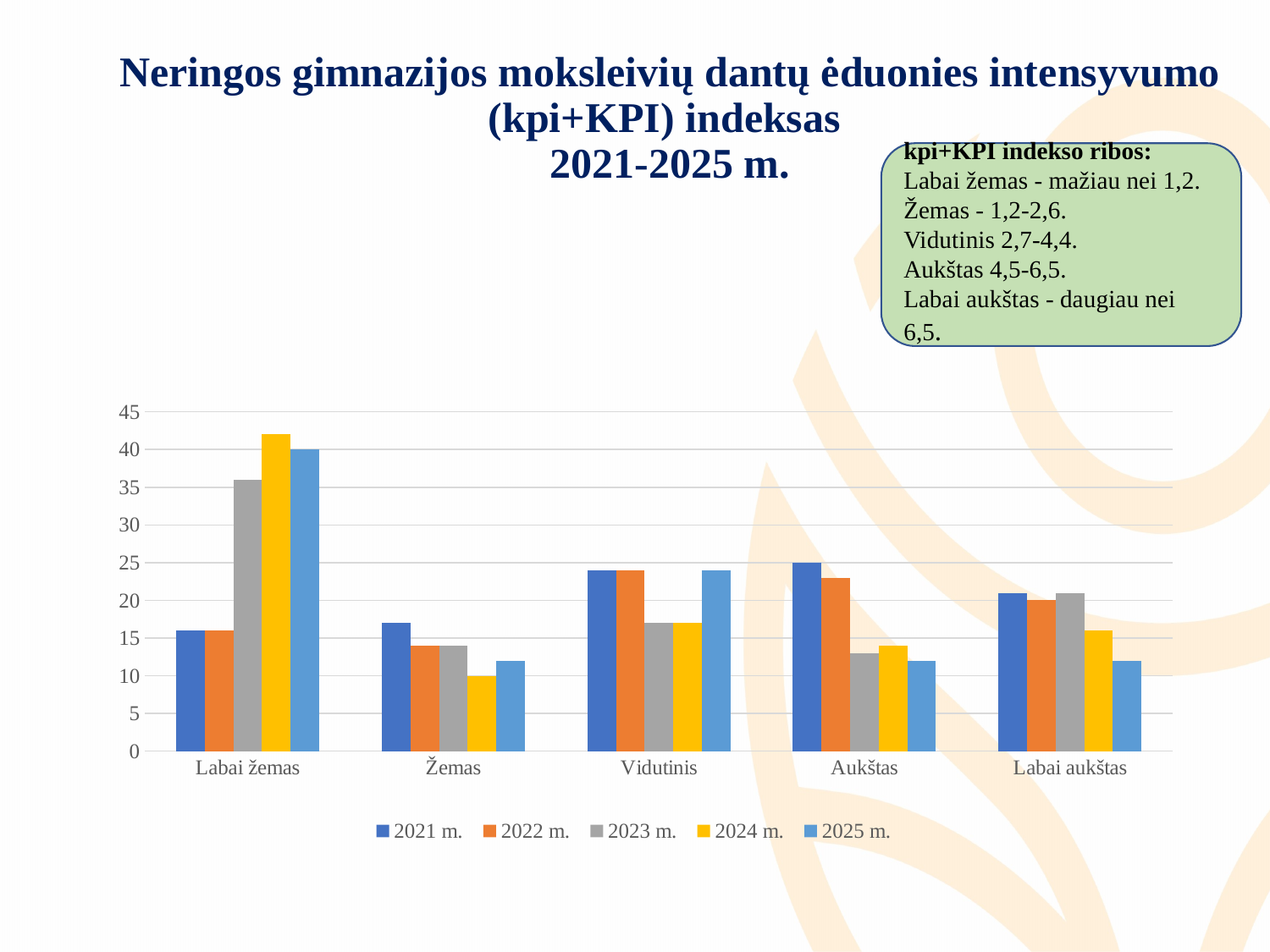
Is the value for 2021 m. in the Vidutinis category greater or less than 20? greater How many categories are shown on the x axis of the chart? 5 In the Labai žemas category, which is larger: the value for 2023 m. or the value for 2022 m.? 2023 m. Which series has the lowest value in the Labai aukštas category? 2025 m. What kind of chart is shown on the slide? bar chart Is the value for 2024 m. in the Labai žemas category greater or less than 40? greater Which series has the lowest value in the Žemas category? 2024 m. Which legend entry is shown in yellow? 2024 m. Is the value for 2025 m. in the Aukštas category greater or less than 15? less Which series has the highest value in the Labai žemas category? 2024 m. How many series does the chart legend list? 5 In the Aukštas category, which is larger: the value for 2021 m. or the value for 2023 m.? 2021 m.